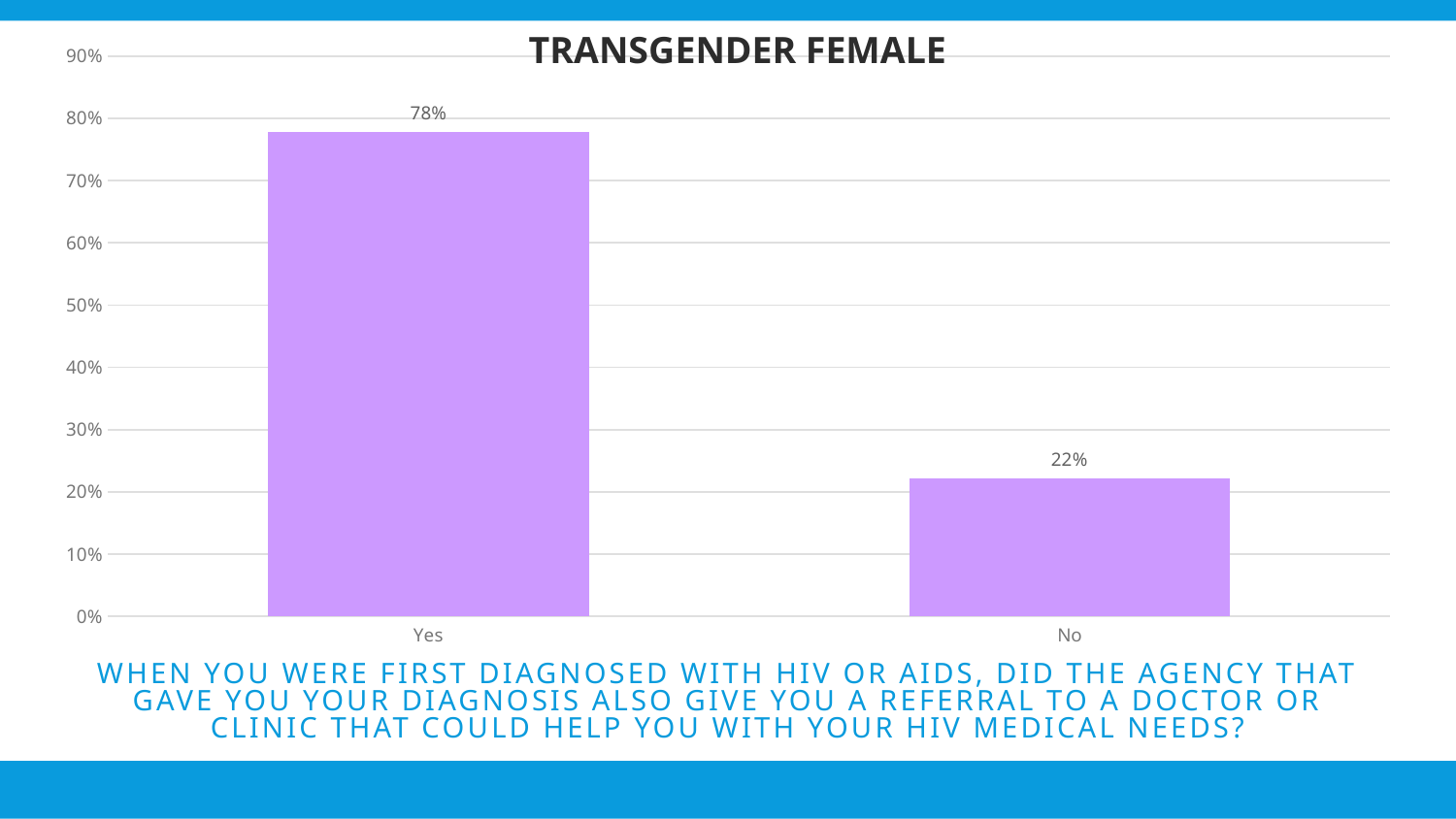
Which is larger, the value for "Yes" or the value for "No"? Yes What kind of chart is shown on the slide? Bar chart What percentage of respondents answered "Yes"? 78% Is the value for "Yes" greater or less than 70%? greater What is the highest value shown on the y axis? 90% Which category has the highest value? Yes What is the difference between the "Yes" and "No" values? 56% What is the title of the chart? TRANSGENDER FEMALE Which category has the lowest value? No How many categories are shown on the x axis? 2 Is the value for "No" greater or less than 30%? less What percentage of respondents answered "No"? 22%